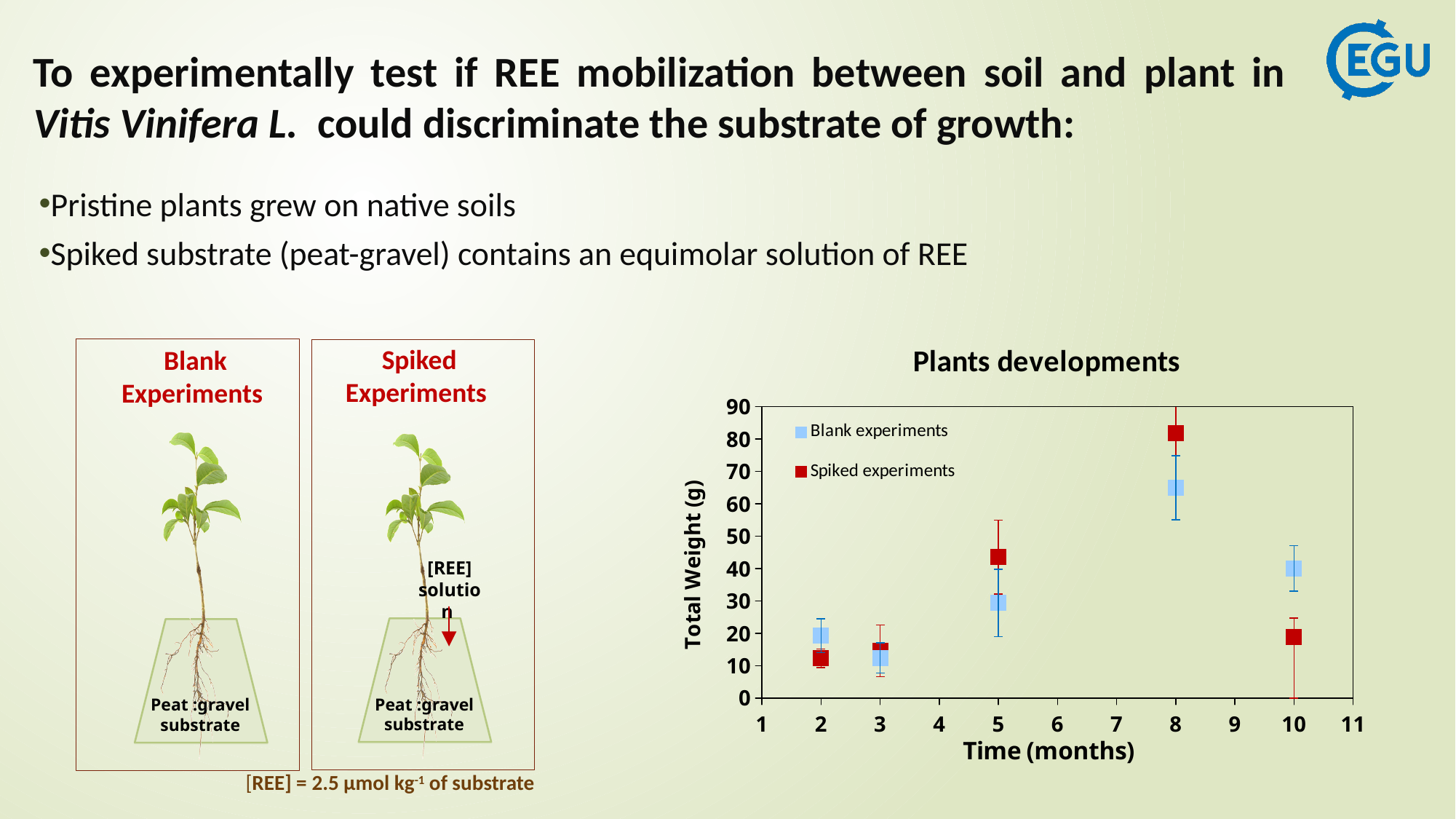
What type of chart is shown under the title "Plants developments"? scatter chart At which time (months) does the Blank experiments series reach its highest total weight? 8 What is the title of the chart on the slide? Plants developments At 5 months, which series has the larger total weight, Blank experiments or Spiked experiments? Spiked experiments How many series does the legend of the "Plants developments" chart list? 2 At 10 months, which series has the larger total weight, Blank experiments or Spiked experiments? Blank experiments How many time points are plotted for the Spiked experiments series? 5 What is the label of the y axis of the "Plants developments" chart? Total Weight (g) Is the value for Spiked experiments at 8 months greater or less than 70? greater At which time (months) does the Spiked experiments series reach its highest total weight? 8 Is the value for Spiked experiments at 10 months greater or less than 30? less Is the value for Blank experiments at 10 months greater or less than 30? greater